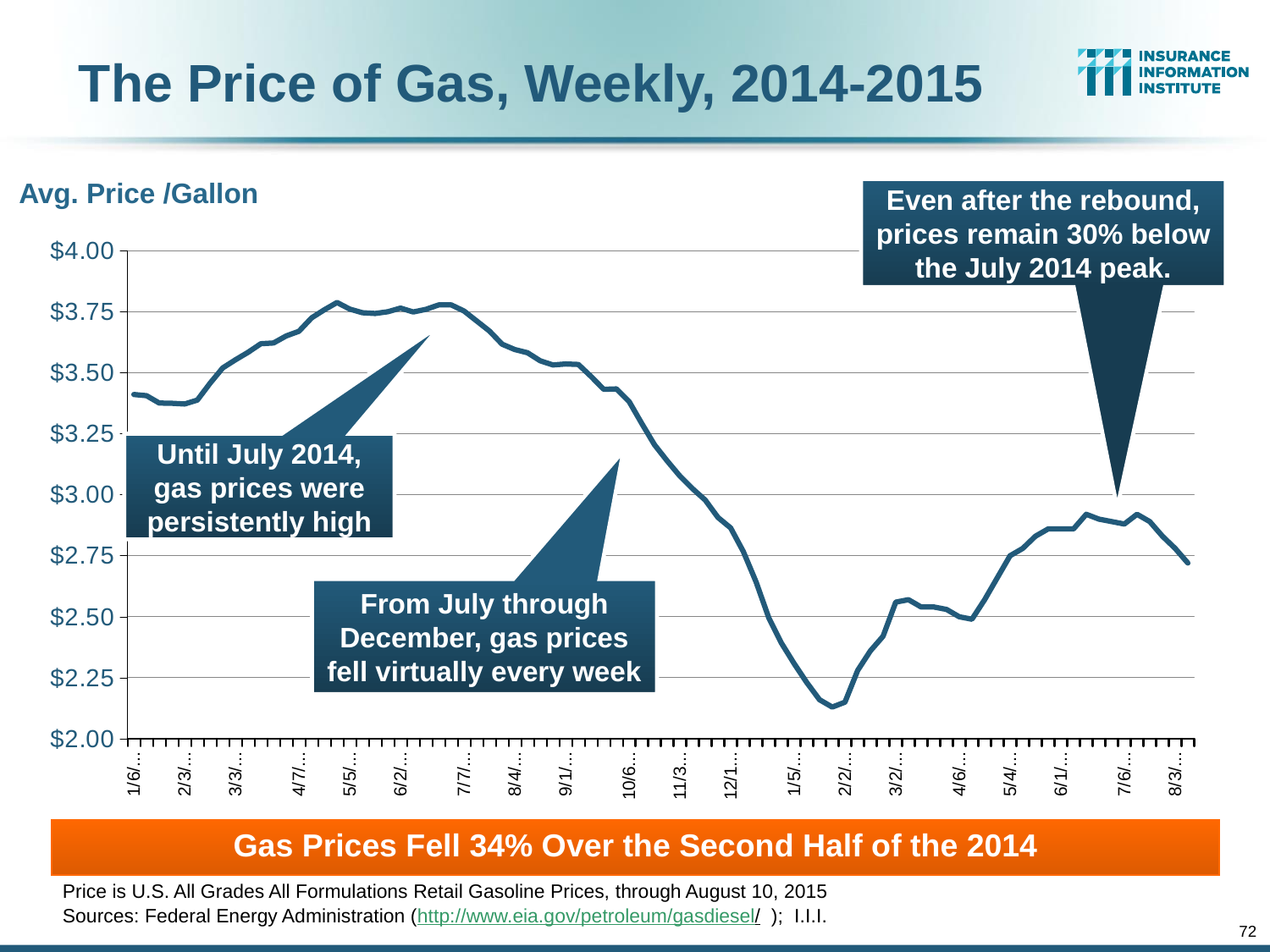
Is the value for 1/6... greater or less than $3.25? greater Is the value for 12/1... greater or less than $3.00? less What kind of chart is shown on the slide? Line chart What is the title of the chart on the slide? The Price of Gas, Weekly, 2014-2015 What label is shown for the vertical axis of the chart? Avg. Price /Gallon Is the value for 7/7... greater or less than $3.50? greater Which is higher, the value for 1/6... or the value for 8/3...? 1/6... Do gas prices rise or fall between 7/7... and 12/1...? fall Do gas prices rise or fall between 2/2... and 6/1...? rise